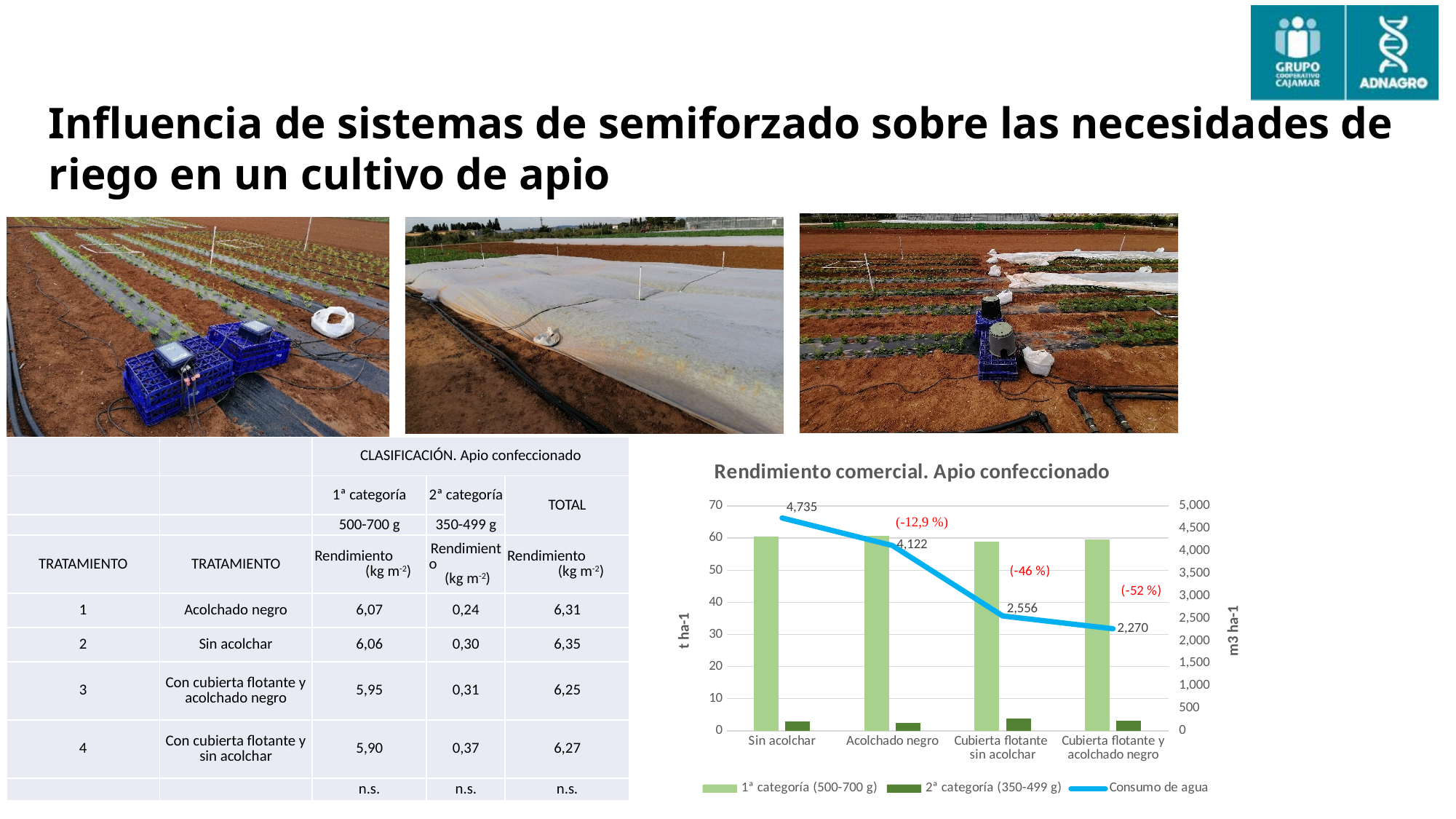
Which treatment has the highest Consumo de agua? Sin acolchar Does the Consumo de agua line rise or fall from left to right across the treatments? Fall What kind of chart is shown on the slide? Combined bar and line chart What is the Consumo de agua value for Cubierta flotante sin acolchar? 2,556 What is the difference in Consumo de agua between Sin acolchar and Cubierta flotante y acolchado negro? 2,465 Is the 1ª categoría (500-700 g) value for Sin acolchar greater or less than 50 t ha-1? greater What is the title of the chart on the slide? Rendimiento comercial. Apio confeccionado How many series does the chart legend list? 3 Which has a higher Consumo de agua, Acolchado negro or Cubierta flotante sin acolchar? Acolchado negro Which treatment has the lowest Consumo de agua? Cubierta flotante y acolchado negro What is the Consumo de agua value for Sin acolchar? 4,735 How many treatment categories are shown on the x axis of the chart? 4